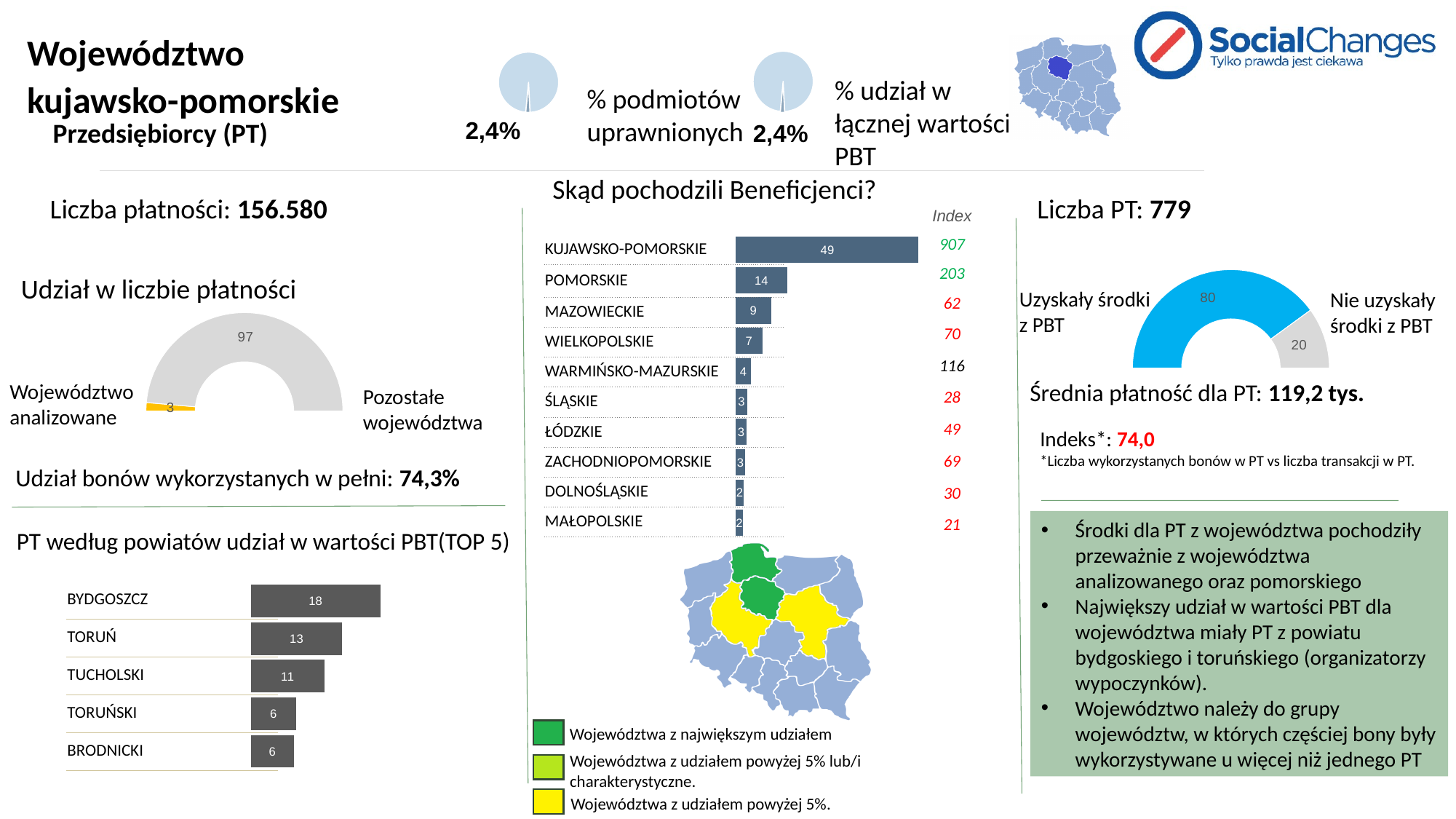
In the 'Skąd pochodzili Beneficjenci?' chart, what is the value for KUJAWSKO-POMORSKIE? 49 In the 'Skąd pochodzili Beneficjenci?' chart, how many voivodeships are listed? 10 In the 'Skąd pochodzili Beneficjenci?' chart, which is larger: the value for MAZOWIECKIE or WIELKOPOLSKIE? MAZOWIECKIE In the 'Udział w liczbie płatności' chart, what is the value for 'Pozostałe województwa'? 97 In the 'Skąd pochodzili Beneficjenci?' chart, which voivodeship has the highest value? KUJAWSKO-POMORSKIE In the 'Skąd pochodzili Beneficjenci?' chart, what is the value for POMORSKIE? 14 What kind of chart is 'PT według powiatów udział w wartości PBT(TOP 5)'? Bar chart In the 'PT według powiatów udział w wartości PBT(TOP 5)' chart, what is the value for TUCHOLSKI? 11 In the 'Skąd pochodzili Beneficjenci?' chart, what is the difference between the values for KUJAWSKO-POMORSKIE and POMORSKIE? 35 In the 'Liczba PT' donut chart, what is the value for 'Uzyskały środki z PBT'? 80 In the 'PT według powiatów udział w wartości PBT(TOP 5)' chart, what is the value for BYDGOSZCZ? 18 In the 'PT według powiatów udział w wartości PBT(TOP 5)' chart, what is the difference between the values for BYDGOSZCZ and TORUŃ? 5